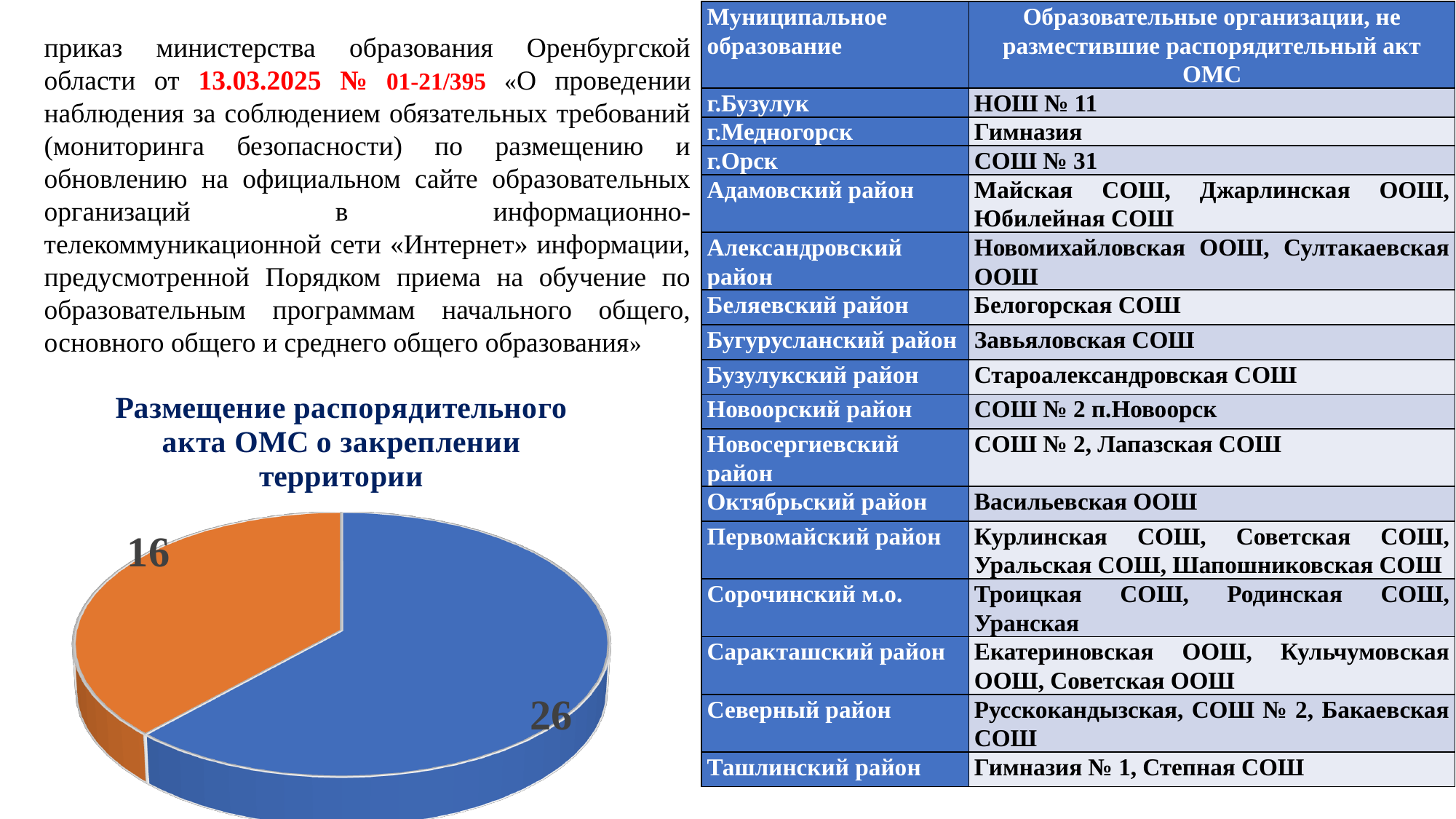
What is the value of the blue slice in the pie chart? 26 Which slice of the pie chart has the smallest value? the orange slice (16) What colour is the slice labelled 16 in the pie chart? orange Which slice of the pie chart is larger, the blue one or the orange one? the blue one What is the total of the two slice values in the pie chart? 42 Which slice of the pie chart has the largest value? the blue slice (26) How many slices does the pie chart have? 2 What is the value of the orange slice in the pie chart? 16 What is the difference between the blue slice value and the orange slice value in the pie chart? 10 What kind of chart is shown on the slide? pie chart What is the title of the pie chart? Размещение распорядительного акта ОМС о закреплении территории